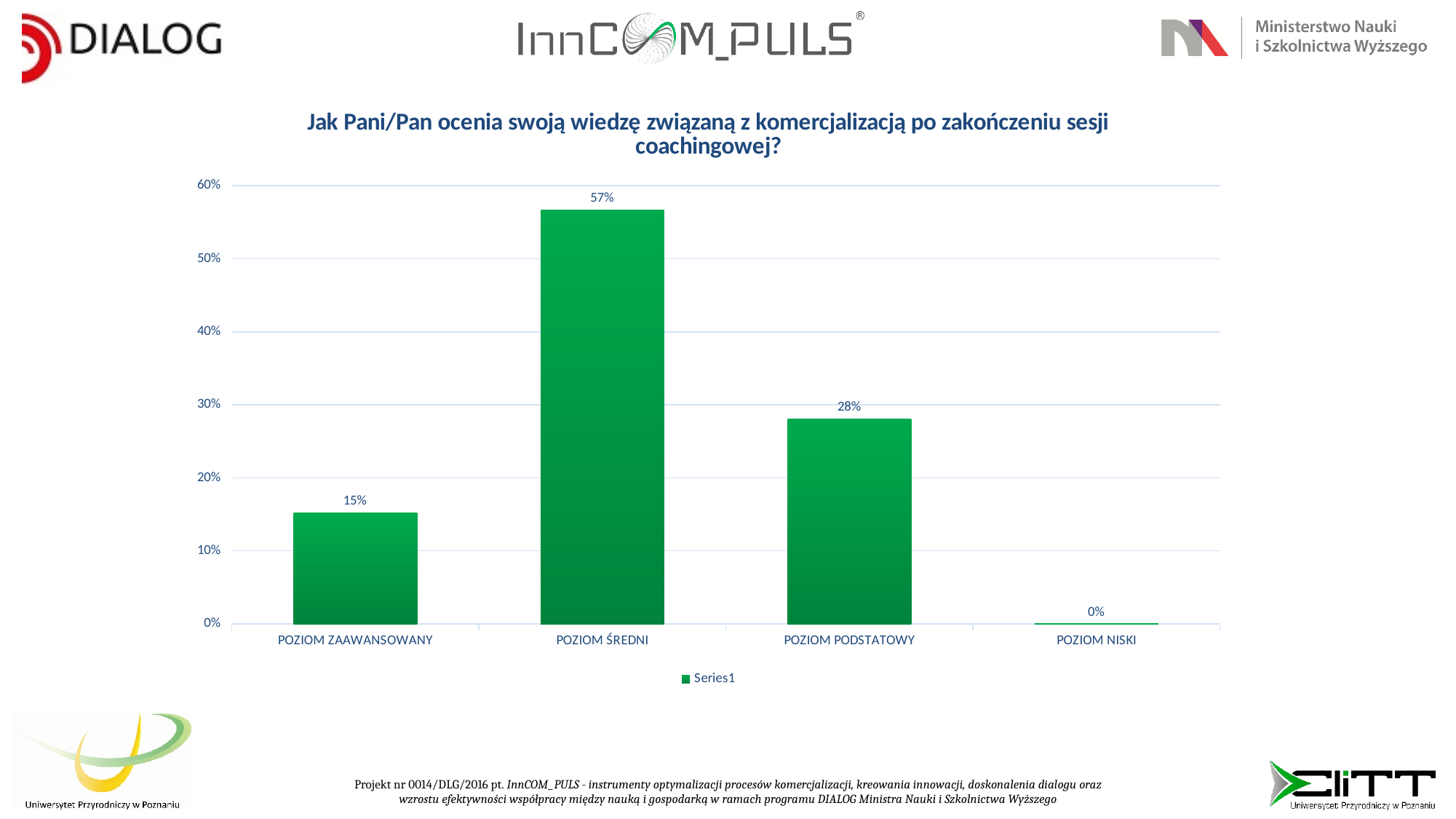
What is the difference between the values for POZIOM ŚREDNI and POZIOM PODSTATOWY? 29% What is the value for POZIOM PODSTATOWY? 28% What is the value for POZIOM ZAAWANSOWANY? 15% What is the value for POZIOM NISKI? 0% What kind of chart is shown on the slide? bar chart Is the value for POZIOM ŚREDNI greater or less than 50%? greater Which is larger, the value for POZIOM ZAAWANSOWANY or the value for POZIOM PODSTATOWY? POZIOM PODSTATOWY Which category has the highest value? POZIOM ŚREDNI What series name does the legend show? Series1 What is the value for POZIOM ŚREDNI? 57% Which category has the lowest value? POZIOM NISKI How many categories are shown on the x axis? 4